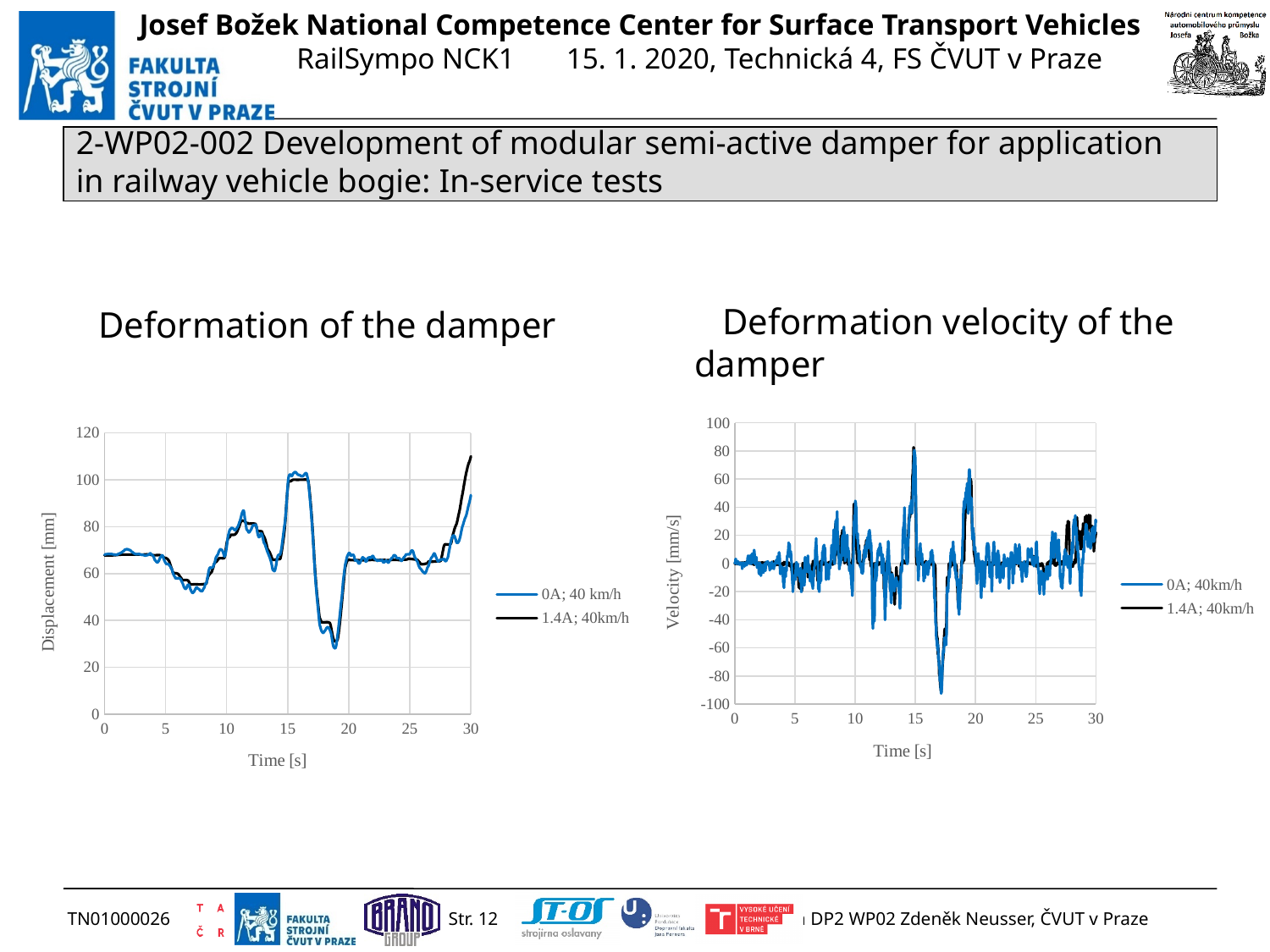
In the 'Deformation velocity of the damper' chart, what is the maximum value shown on the x axis? 30 In the 'Deformation of the damper' chart, is the peak displacement of the '1.4A; 40km/h' series around 16 s greater or less than 80? greater What kind of chart is the 'Deformation velocity of the damper' chart? line chart How many series does the legend of the 'Deformation of the damper' chart list? 2 What kind of chart is the 'Deformation of the damper' chart? line chart In the 'Deformation velocity of the damper' chart, is the highest velocity reached around 15 s greater or less than 60? greater In the 'Deformation of the damper' chart, is the displacement of the '0A; 40 km/h' series at time 0 s greater or less than 60? greater How many series does the legend of the 'Deformation velocity of the damper' chart list? 2 In the 'Deformation of the damper' chart, what is the label of the y axis? Displacement [mm] In the 'Deformation velocity of the damper' chart, what is the label of the y axis? Velocity [mm/s]